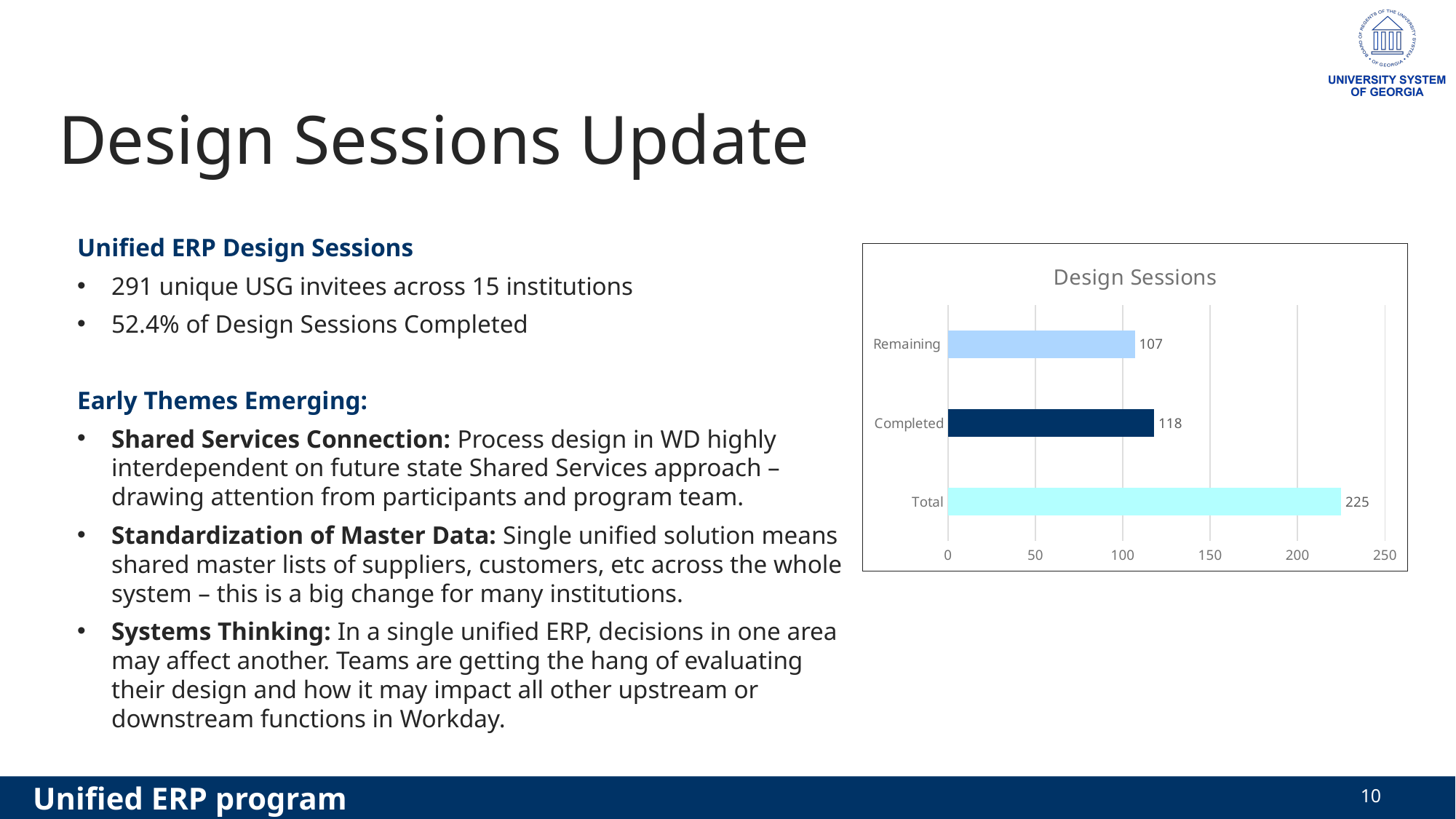
What is the value for Remaining in the Design Sessions chart? 107 Is the value for Total in the Design Sessions chart greater or less than 200? greater Which category has the highest value in the Design Sessions chart? Total What is the value for Total in the Design Sessions chart? 225 What is the value for Completed in the Design Sessions chart? 118 What kind of chart is the Design Sessions chart? Bar chart What is the difference between the Completed and Remaining values in the Design Sessions chart? 11 Which is larger in the Design Sessions chart, Completed or Remaining? Completed How many categories are shown in the Design Sessions chart? 3 What is the title of the chart on the slide? Design Sessions What is the difference between the Total and Completed values in the Design Sessions chart? 107 Which category has the lowest value in the Design Sessions chart? Remaining